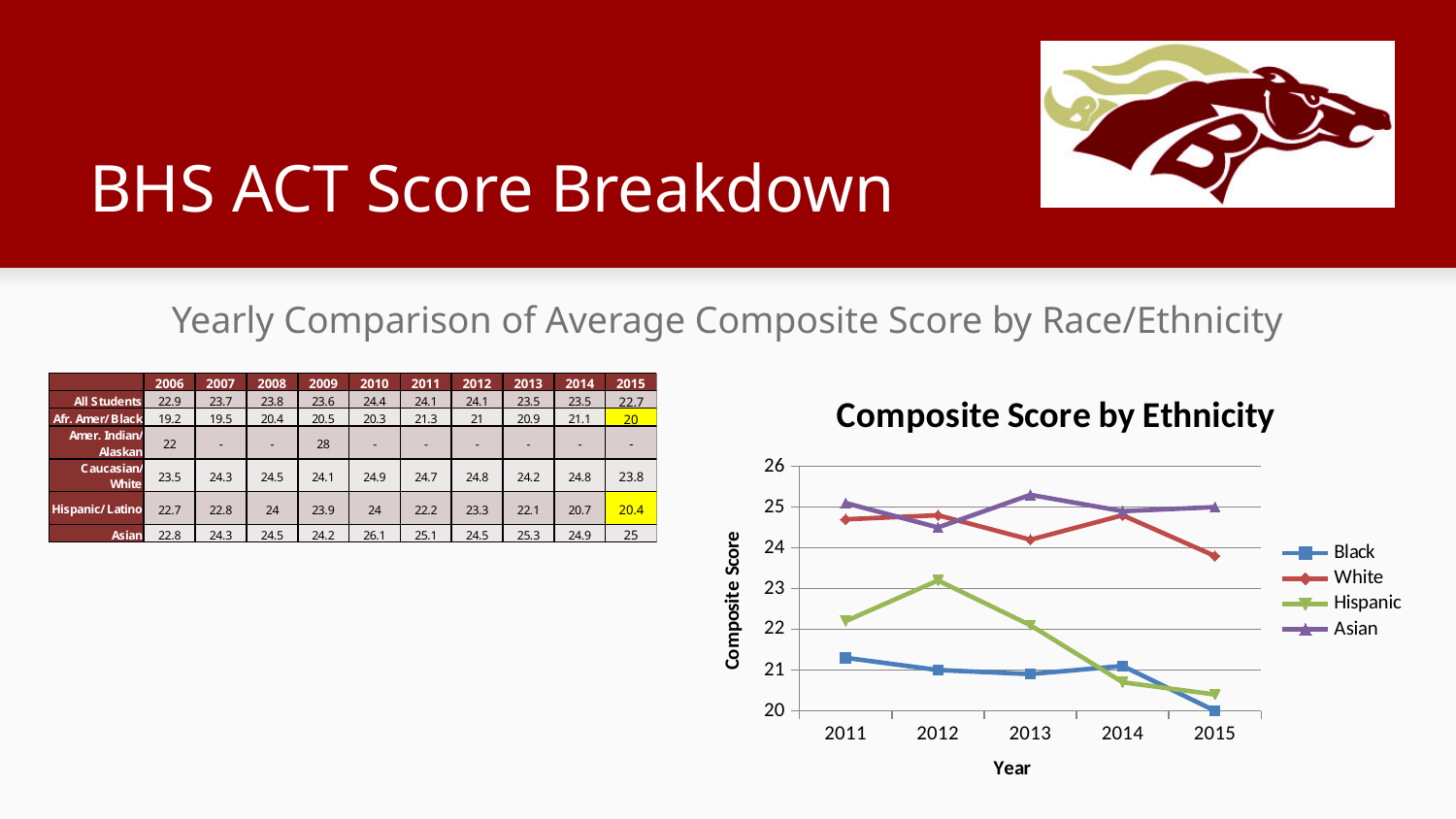
In the "Composite Score by Ethnicity" chart, what is the Black composite score in 2015? 20 In the "Composite Score by Ethnicity" chart, what is the Asian composite score in 2015? 25 What is the label on the y axis of the "Composite Score by Ethnicity" chart? Composite Score In the "Composite Score by Ethnicity" chart, is the Hispanic value for 2012 greater or less than 23? greater In the "Composite Score by Ethnicity" chart, which is higher in 2014, Black or Hispanic? Black In the "Composite Score by Ethnicity" chart, does the Hispanic series rise or fall from 2012 to 2015? fall In the "Composite Score by Ethnicity" chart, which series has the highest value in 2013? Asian How many series does the legend of the "Composite Score by Ethnicity" chart list? 4 How many years are shown on the x axis of the "Composite Score by Ethnicity" chart? 5 In the "Composite Score by Ethnicity" chart, is the White value for 2015 greater or less than 24? less What kind of chart is "Composite Score by Ethnicity"? line chart In the "Composite Score by Ethnicity" chart, which series has the lowest value in 2011? Black